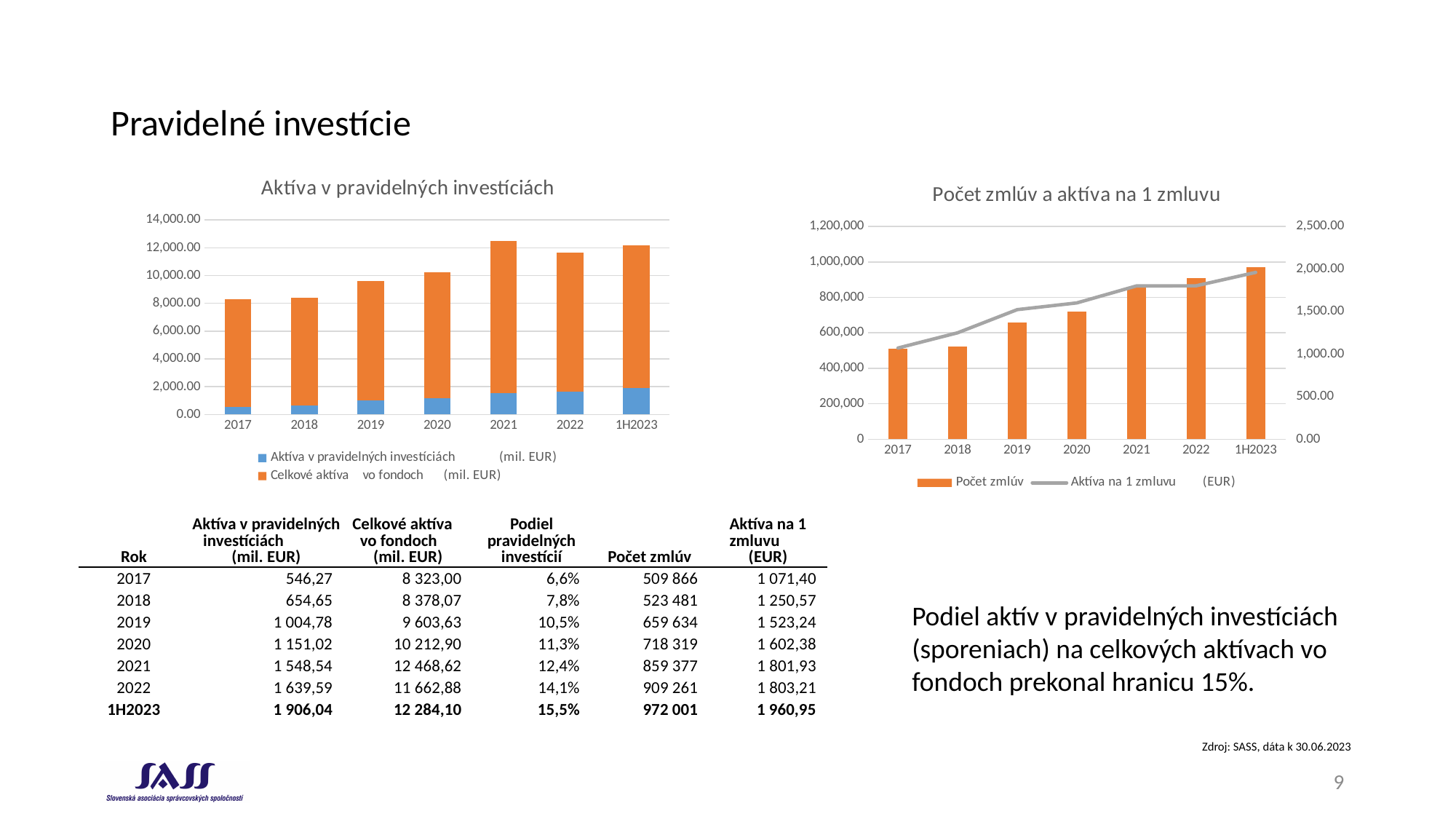
What kind of chart is the right chart titled "Počet zmlúv a aktíva na 1 zmluvu"? combined bar and line chart In the left chart "Aktíva v pravidelných investíciách", how many periods are shown on the x axis? 7 How many series does the legend of the left chart "Aktíva v pravidelných investíciách" list? 2 In the left chart "Aktíva v pravidelných investíciách", which period has the highest Celkové aktíva vo fondoch? 2021 In the right chart "Počet zmlúv a aktíva na 1 zmluvu", which is larger, Počet zmlúv for 2019 or for 2020? 2020 What kind of chart is the left chart titled "Aktíva v pravidelných investíciách"? bar chart In the left chart "Aktíva v pravidelných investíciách", which period has the lowest Aktíva v pravidelných investíciách? 2017 In the right chart "Počet zmlúv a aktíva na 1 zmluvu", does the Aktíva na 1 zmluvu line rise or fall from 2017 to 1H2023? rises How many series does the legend of the right chart "Počet zmlúv a aktíva na 1 zmluvu" list? 2 According to the table on the slide, what is the Počet zmlúv value for 1H2023? 972 001 In the left chart "Aktíva v pravidelných investíciách", is the Celkové aktíva vo fondoch value for 2017 greater or less than 10,000.00? less In the right chart "Počet zmlúv a aktíva na 1 zmluvu", is the Počet zmlúv value for 2021 greater or less than 800,000? greater